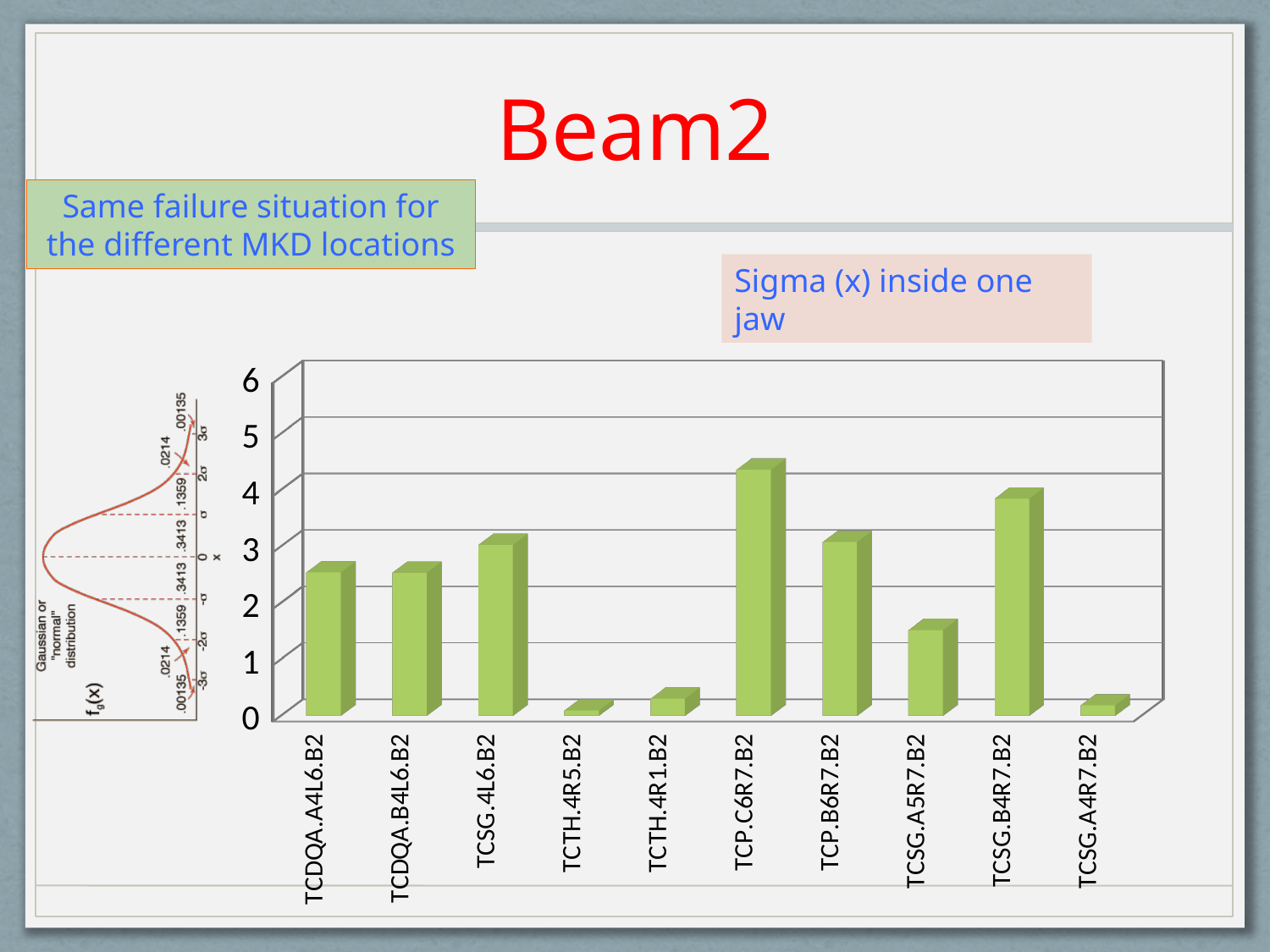
What kind of chart is shown on the slide? bar chart How many categories are plotted on the x axis of the chart? 10 What colour are the bars in the chart? green Which is larger, the value for TCP.C6R7.B2 or the value for TCSG.B4R7.B2? TCP.C6R7.B2 Is the value for TCSG.A5R7.B2 greater or less than 2? less Is the value for TCP.C6R7.B2 greater or less than 4? greater Which is larger, the value for TCDQA.A4L6.B2 or the value for TCSG.A5R7.B2? TCDQA.A4L6.B2 Is the value for TCDQA.A4L6.B2 greater or less than 2? greater Which category has the highest bar in the chart? TCP.C6R7.B2